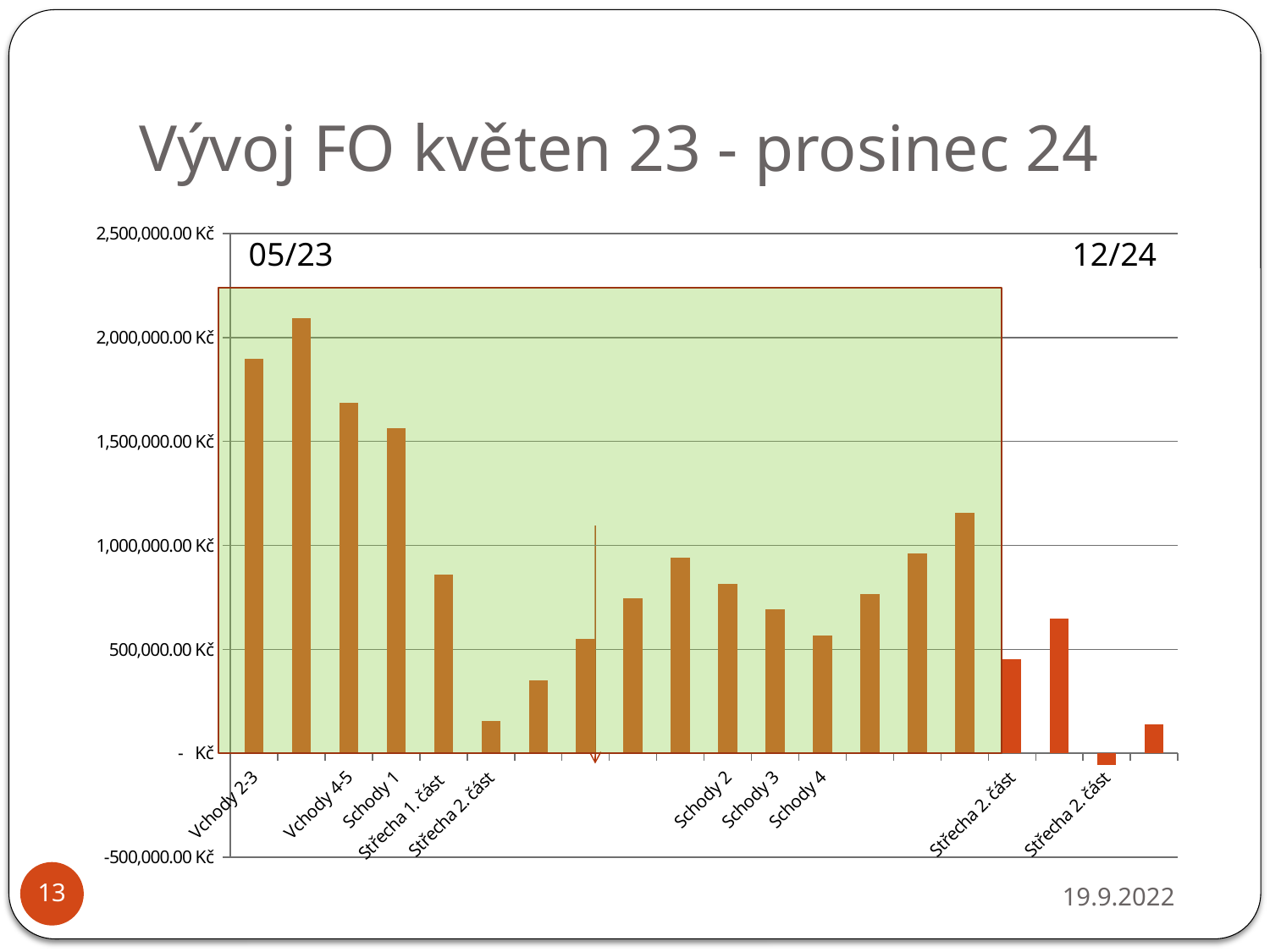
Overall, do the values rise or fall from the left of the chart to the right? fall Is the value for Schody 2 greater or less than 1,000,000.00 Kč? less Is the value for Schody 3 greater or less than 500,000.00 Kč? greater Is the value for Schody 4 greater or less than 1,000,000.00 Kč? less What is the title of the chart on the slide? Vývoj FO květen 23 - prosinec 24 Which is larger, the value for Vchody 2-3 or the value for Schody 2? Vchody 2-3 How many bars in the chart are drawn in red rather than brown? 4 What kind of chart is shown on the slide? bar chart What is the highest value shown on the vertical axis? 2,500,000.00 Kč How many bars are plotted in the chart? 20